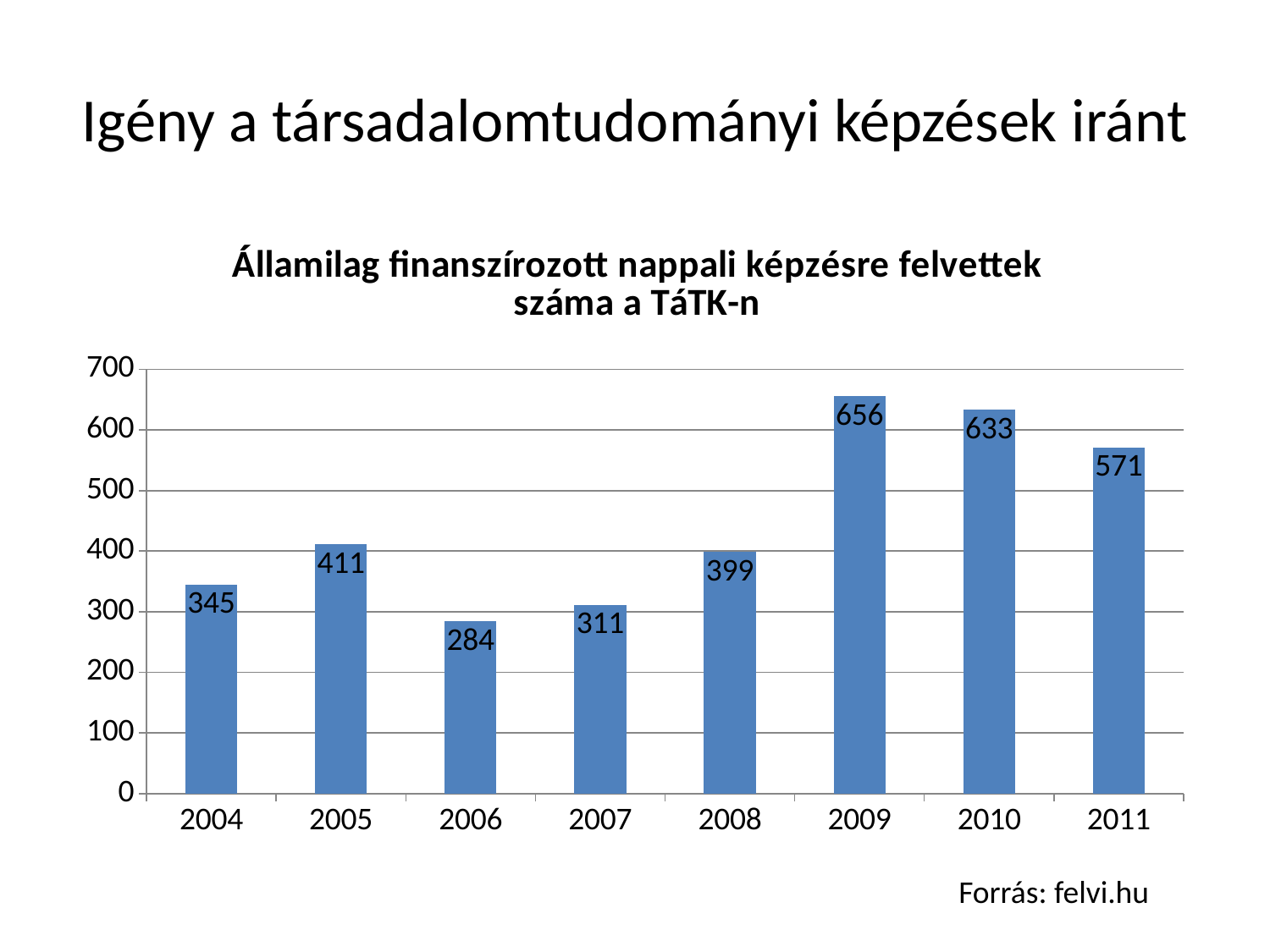
Is the value for 2010 greater or less than 600? greater What is the value for 2008? 399 What is the difference between the values for 2005 and 2006? 127 What is the title of the chart? Államilag finanszírozott nappali képzésre felvettek száma a TáTK-n What is the value for 2011? 571 How many years are shown on the x axis? 8 Which is larger, the value for 2007 or the value for 2008? 2008 What kind of chart is shown on the slide? bar chart What is the difference between the values for 2009 and 2010? 23 Which year has the lowest value? 2006 Which year has the highest value? 2009 What is the value for 2004? 345